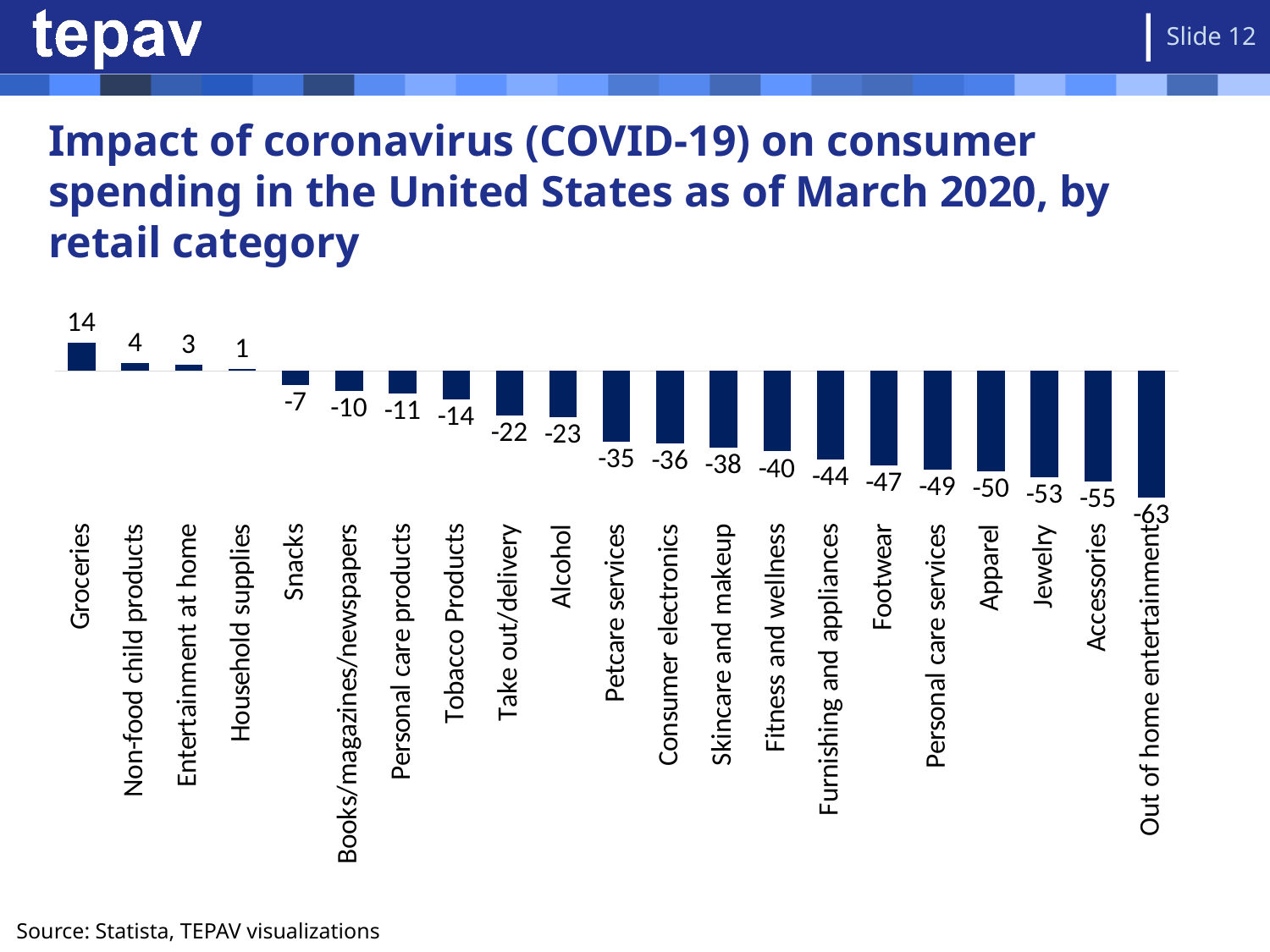
What is the difference between the values for Groceries and Non-food child products? 10 What is the value for Apparel? -50 Do the values rise or fall moving from left to right along the x axis? Fall Which category has the lowest value? Out of home entertainment What is the value for Out of home entertainment? -63 How many retail categories are shown in the chart? 21 How many categories have a positive value? 4 What is the value for Groceries? 14 What is the value for Take out/delivery? -22 What kind of chart is shown on the slide? Bar chart Which has a larger value, Snacks or Alcohol? Snacks Which category has the highest value? Groceries